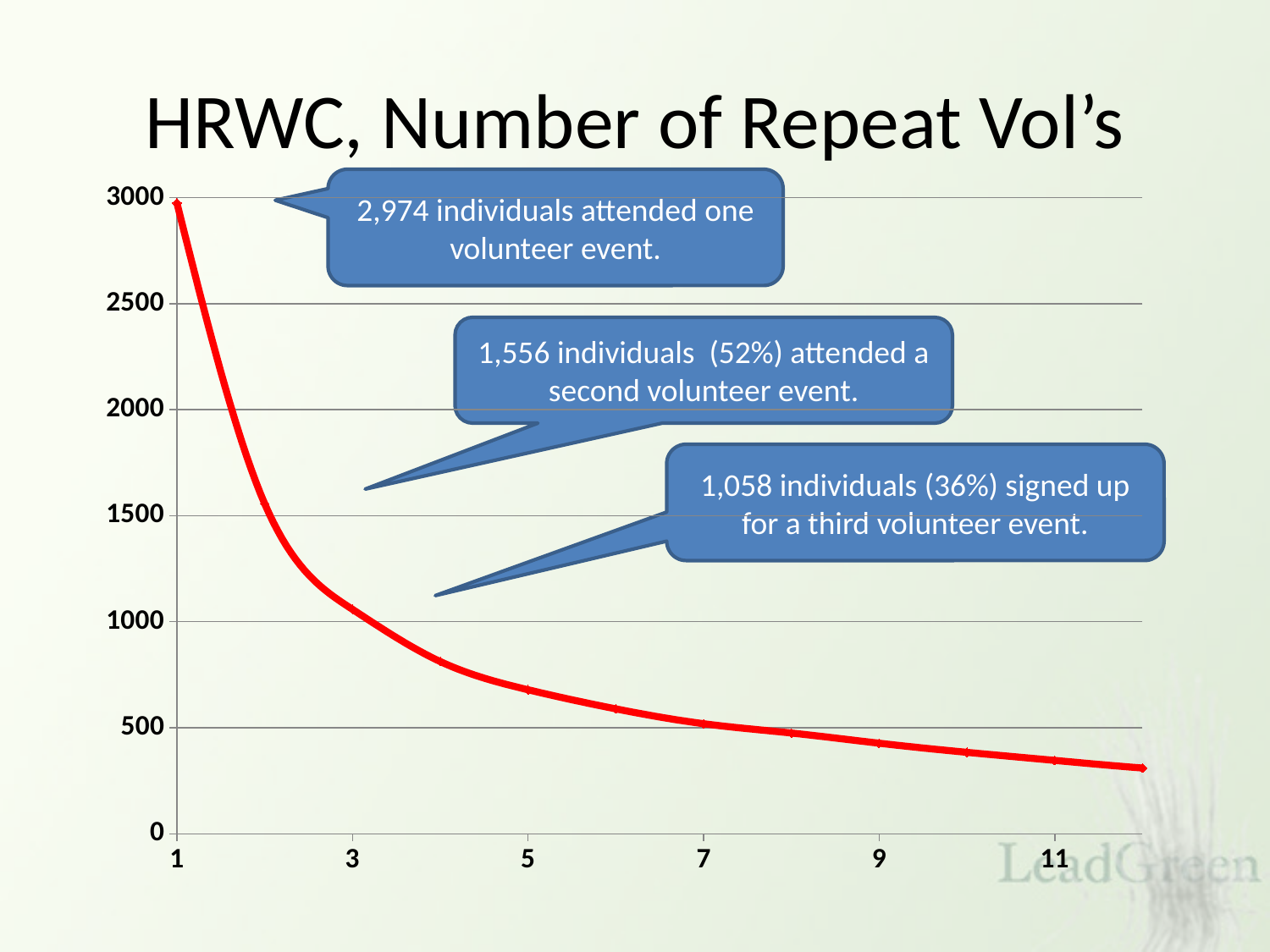
What is the difference between the number of individuals who attended one event and the number who attended a second event? 1,418 How many individuals attended one volunteer event (the value at x = 1)? 2,974 What percentage of individuals attended a second volunteer event, according to the callout? 52% What type of chart is shown on the slide? line chart What is the difference between the number who attended a second event and the number who signed up for a third event? 498 At which x value is the plotted value highest? 1 Is the value at x = 9 greater or less than 500? less How many individuals signed up for a third volunteer event (the value at x = 3)? 1,058 Do the values rise or fall as the x axis increases? fall Is the value at x = 5 greater or less than 1000? less What is the title of the chart? HRWC, Number of Repeat Vol's How many individuals attended a second volunteer event (the value at x = 2)? 1,556